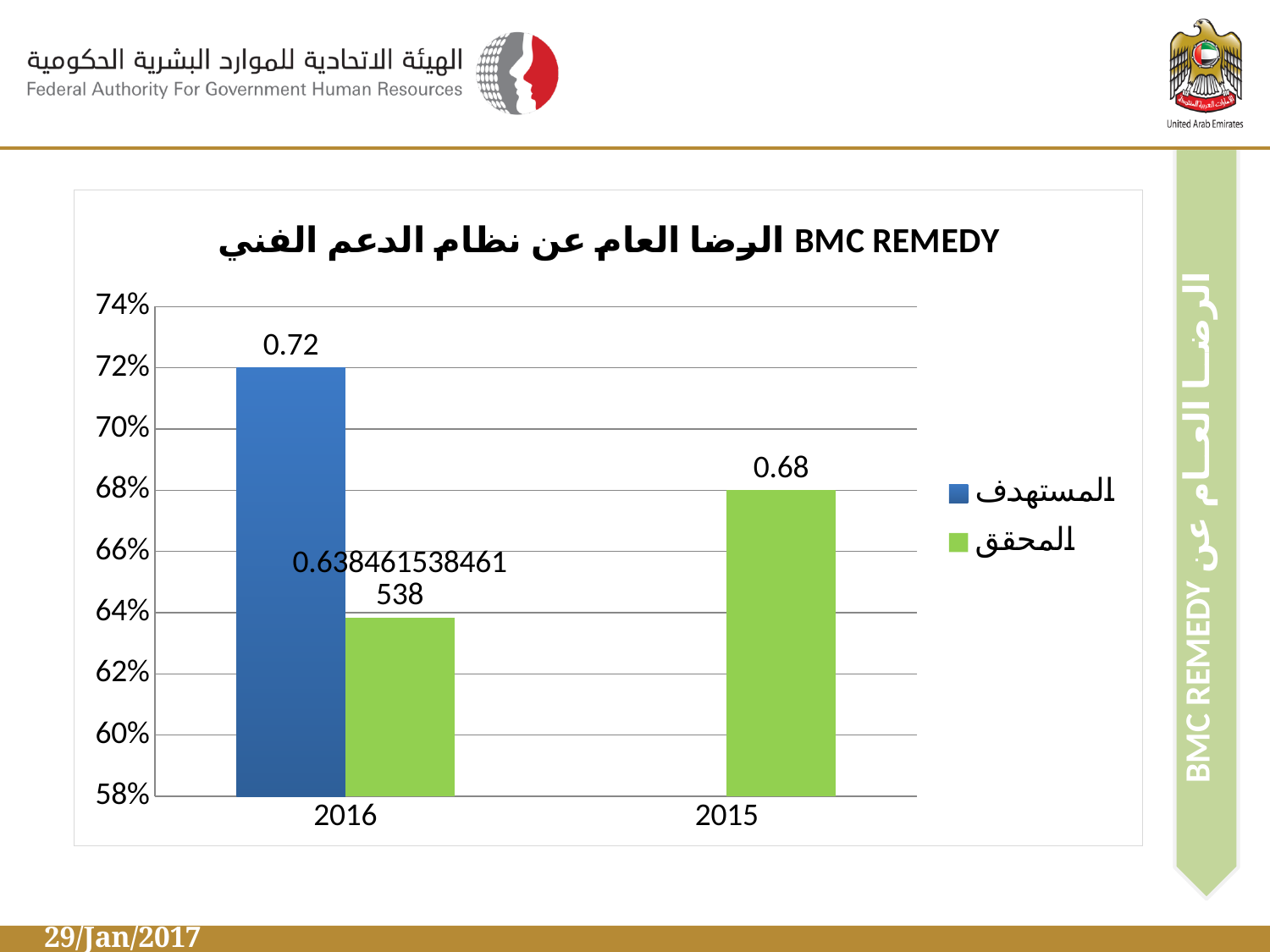
What type of chart is shown on the slide? bar chart What is the value of المستهدف for 2016? 0.72 Which bar has the lowest value in the chart? المحقق for 2016 How many categories are shown on the x axis? 2 Is the value of المحقق for 2016 greater or less than 66%? less What is the difference between المستهدف for 2016 and المحقق for 2015? 0.04 How many series does the legend list? 2 Which colour represents the المستهدف series in the legend? blue Which bar has the highest value in the chart? المستهدف for 2016 Which is larger, المحقق for 2016 or المحقق for 2015? المحقق for 2015 What is the value of المحقق for 2015? 0.68 What is the value of المحقق for 2016? 0.638461538461538